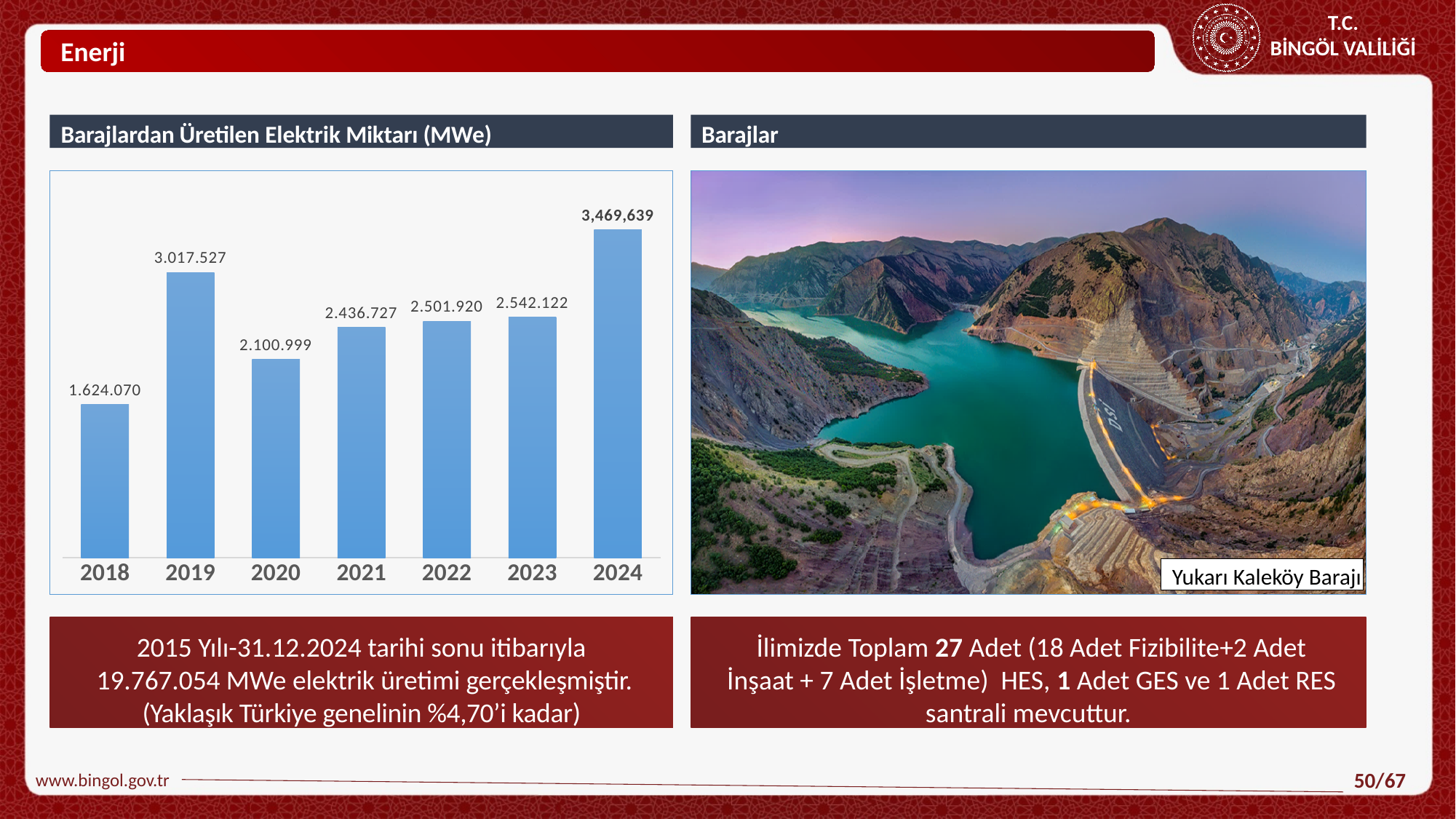
In the chart 'Barajlardan Üretilen Elektrik Miktarı (MWe)', what is the difference between the values for 2019 and 2018? 1.393.457 Which year has the lowest value in the chart 'Barajlardan Üretilen Elektrik Miktarı (MWe)'? 2018 In the chart 'Barajlardan Üretilen Elektrik Miktarı (MWe)', which is larger, the value for 2021 or the value for 2023? 2023 Which year has the highest value in the chart 'Barajlardan Üretilen Elektrik Miktarı (MWe)'? 2024 What is the value for 2024 in the chart 'Barajlardan Üretilen Elektrik Miktarı (MWe)'? 3,469,639 How many years are shown in the chart 'Barajlardan Üretilen Elektrik Miktarı (MWe)'? 7 In the chart 'Barajlardan Üretilen Elektrik Miktarı (MWe)', what is the difference between the values for 2023 and 2022? 40.202 What kind of chart is 'Barajlardan Üretilen Elektrik Miktarı (MWe)'? Bar chart What is the value for 2021 in the chart 'Barajlardan Üretilen Elektrik Miktarı (MWe)'? 2.436.727 What is the value for 2018 in the chart 'Barajlardan Üretilen Elektrik Miktarı (MWe)'? 1.624.070 In the chart 'Barajlardan Üretilen Elektrik Miktarı (MWe)', which is larger, the value for 2019 or the value for 2020? 2019 In the chart 'Barajlardan Üretilen Elektrik Miktarı (MWe)', do the values rise or fall from 2020 to 2024? Rise